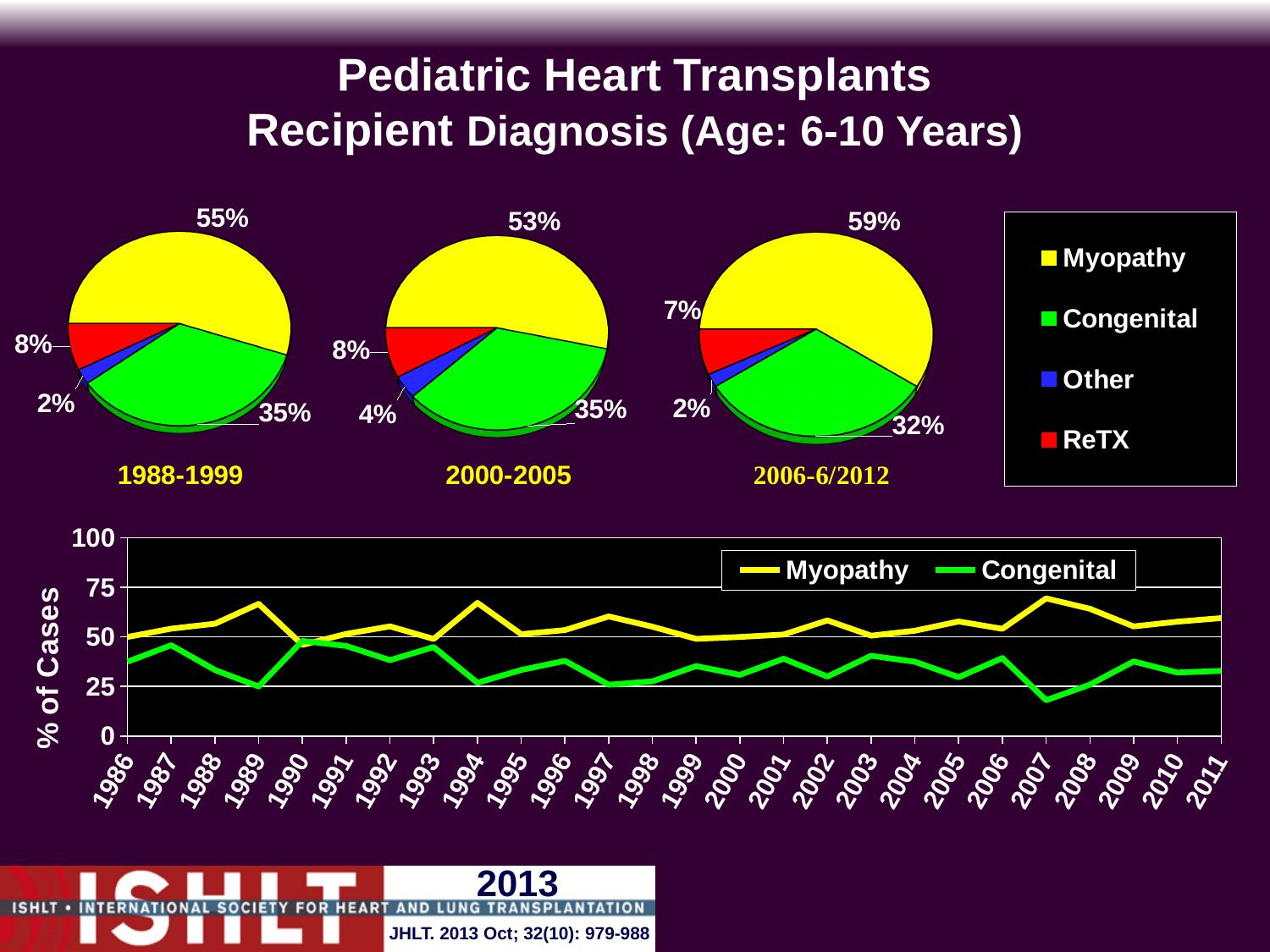
In the 1988-1999 pie chart, what share of recipients had Myopathy? 55% How many series does the legend for the pie charts list? 4 Is the ReTX share larger in the 2000-2005 pie chart or the 2006-6/2012 pie chart? 2000-2005 In the 2006-6/2012 pie chart, what is the difference between the Myopathy and Congenital shares? 27% In the 2006-6/2012 pie chart, which diagnosis has the largest share? Myopathy In the 1988-1999 pie chart, which diagnosis has the smallest share? Other How many years are shown on the x axis of the bottom line chart? 26 In the 2006-6/2012 pie chart, what percentage is shown for Congenital? 32% In the 2000-2005 pie chart, what percentage is shown for Other? 4% In the bottom line chart, is the Myopathy value for 2007 greater or less than 50? greater What kind of chart is the bottom chart showing % of Cases by year? Line chart In the bottom line chart, is the Congenital value for 2007 greater or less than 25? less